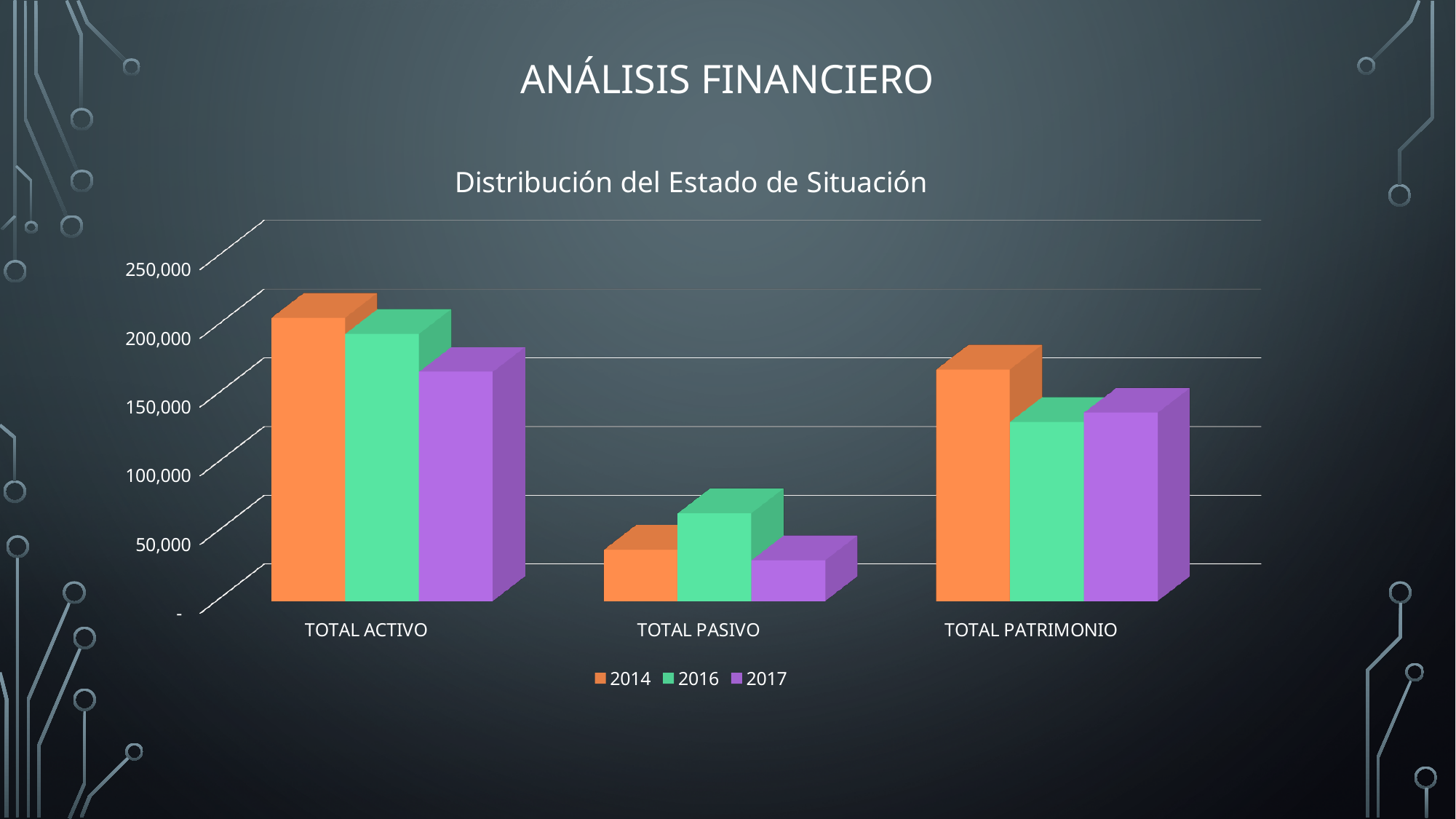
What is the title of the chart? Distribución del Estado de Situación Which year has the highest value for TOTAL ACTIVO? 2014 Which year has the lowest value for TOTAL ACTIVO? 2017 Is the value for TOTAL PASIVO in 2016 greater or less than 100,000? less Which is larger in 2014: TOTAL ACTIVO or TOTAL PATRIMONIO? TOTAL ACTIVO Do the values for TOTAL ACTIVO rise or fall from 2014 to 2017? fall How many series does the legend list? 3 How many categories are shown on the x axis? 3 Is the value for TOTAL ACTIVO in 2014 greater or less than 150,000? greater What kind of chart is shown on the slide? Bar chart Which year has the highest value for TOTAL PASIVO? 2016 Which category has the lowest values across all three years? TOTAL PASIVO